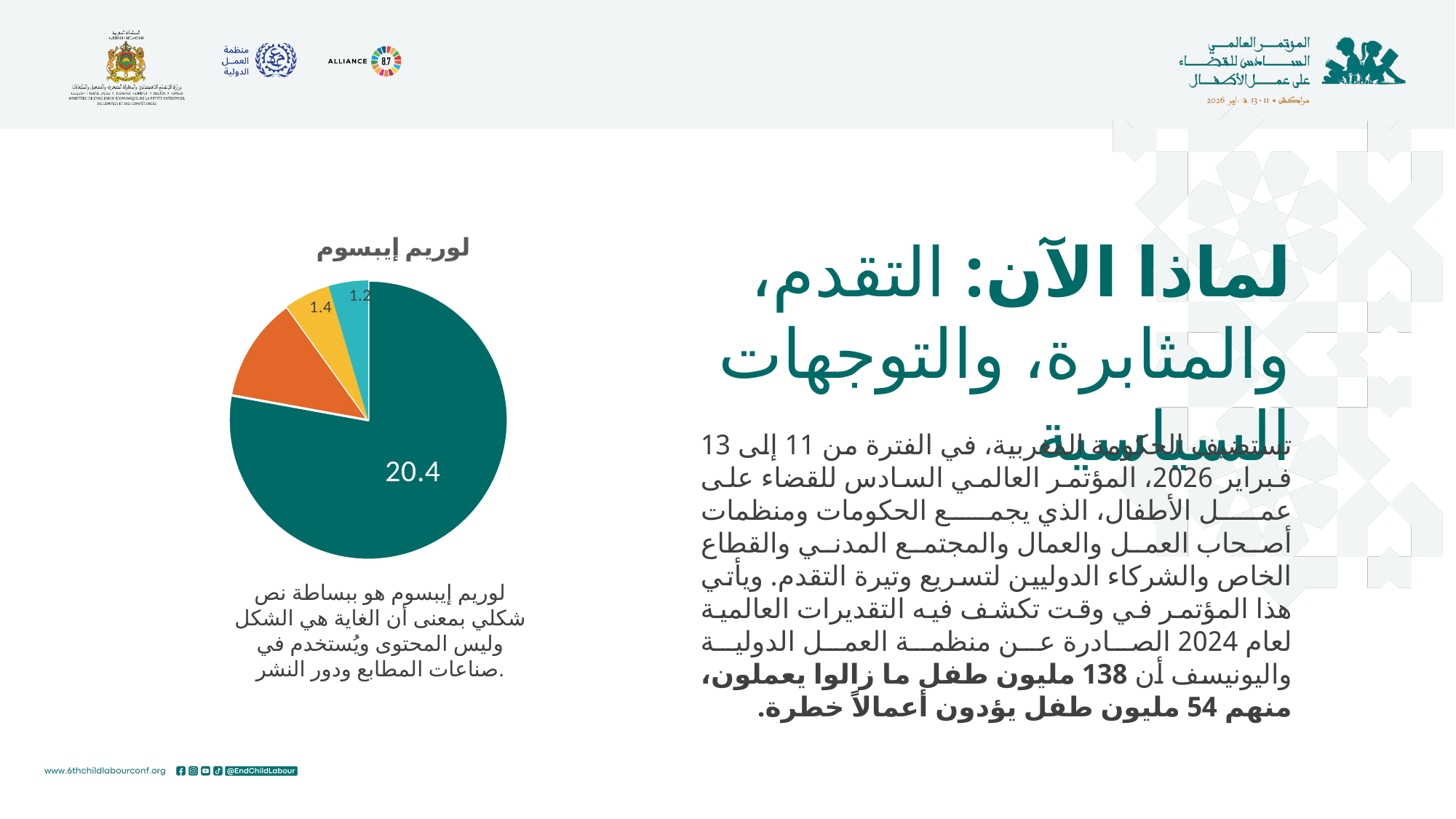
What value is labelled on the largest (dark teal) slice of the pie chart? 20.4 What kind of chart is shown on the slide? pie chart How many slices does the pie chart have? 4 What value is labelled on the yellow slice of the pie chart? 1.4 Which is larger in the pie chart, the orange slice or the light blue slice? the orange slice Which slice of the pie chart is the smallest? the light blue slice (1.2) Which slice of the pie chart is the largest? the dark teal slice (20.4) Does the pie chart have a legend? No What is the title of the pie chart? لوريم إيبسوم What value is labelled on the light blue slice of the pie chart? 1.2 Which is larger in the pie chart, the dark teal slice or the yellow slice? the dark teal slice What is the difference between the yellow slice (1.4) and the light blue slice (1.2) in the pie chart? 0.2